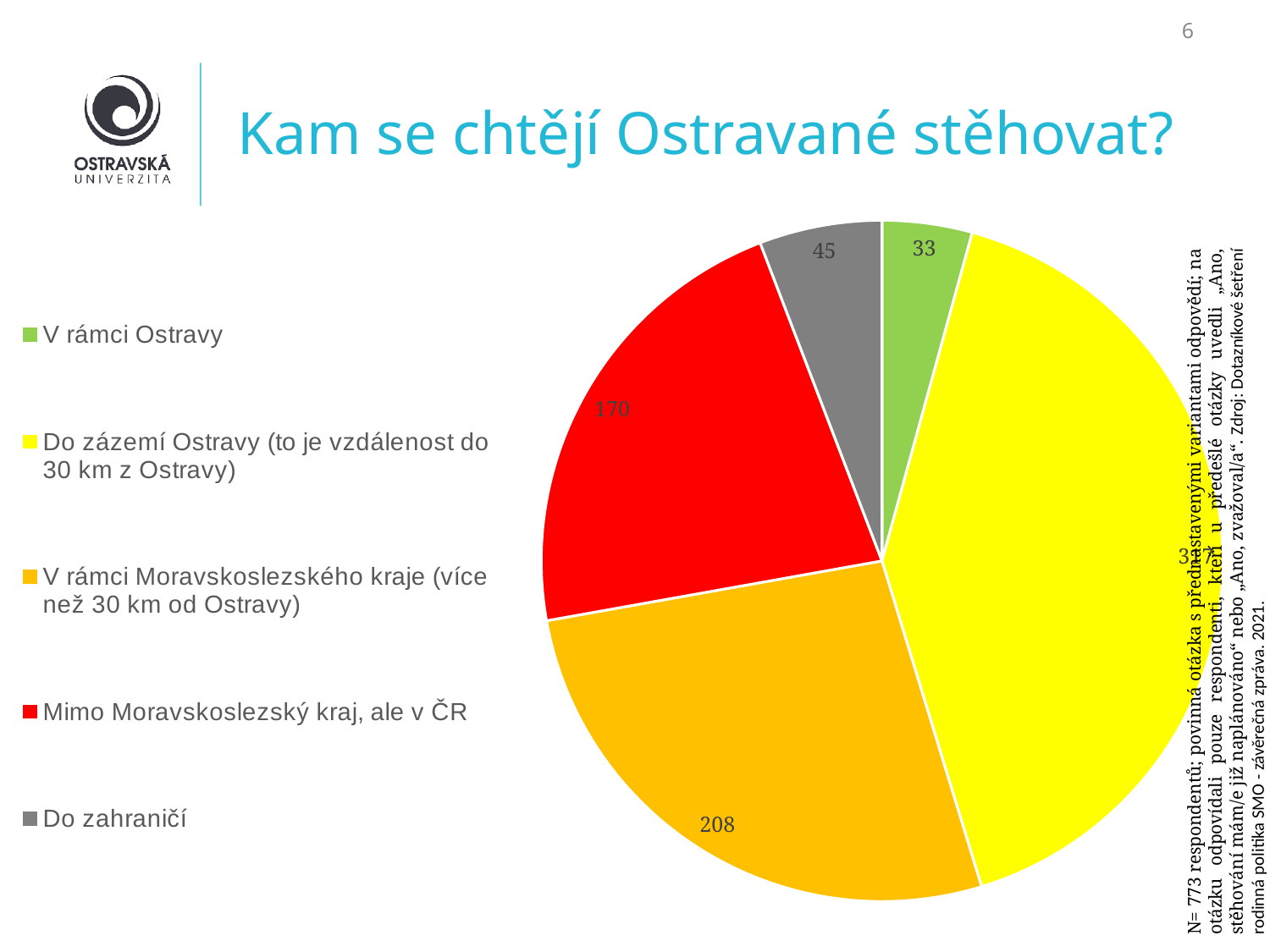
Which category has the largest slice of the pie chart? Do zázemí Ostravy (to je vzdálenost do 30 km z Ostravy) What is the value for "V rámci Ostravy" in the pie chart? 33 What is the value for "Mimo Moravskoslezský kraj, ale v ČR"? 170 What is the value for "Do zahraničí"? 45 What is the difference between the values for "V rámci Moravskoslezského kraje" and "Mimo Moravskoslezský kraj, ale v ČR"? 38 How many categories does the pie chart have? 5 What is the difference between the values for "Do zahraničí" and "V rámci Ostravy"? 12 Which is larger: the value for "V rámci Moravskoslezského kraje" or for "Mimo Moravskoslezský kraj, ale v ČR"? V rámci Moravskoslezského kraje What type of chart is shown on the slide? Pie chart What colour represents "Mimo Moravskoslezský kraj, ale v ČR" in the pie chart? Red What is the value for "V rámci Moravskoslezského kraje (více než 30 km od Ostravy)"? 208 Which category has the smallest slice of the pie chart? V rámci Ostravy